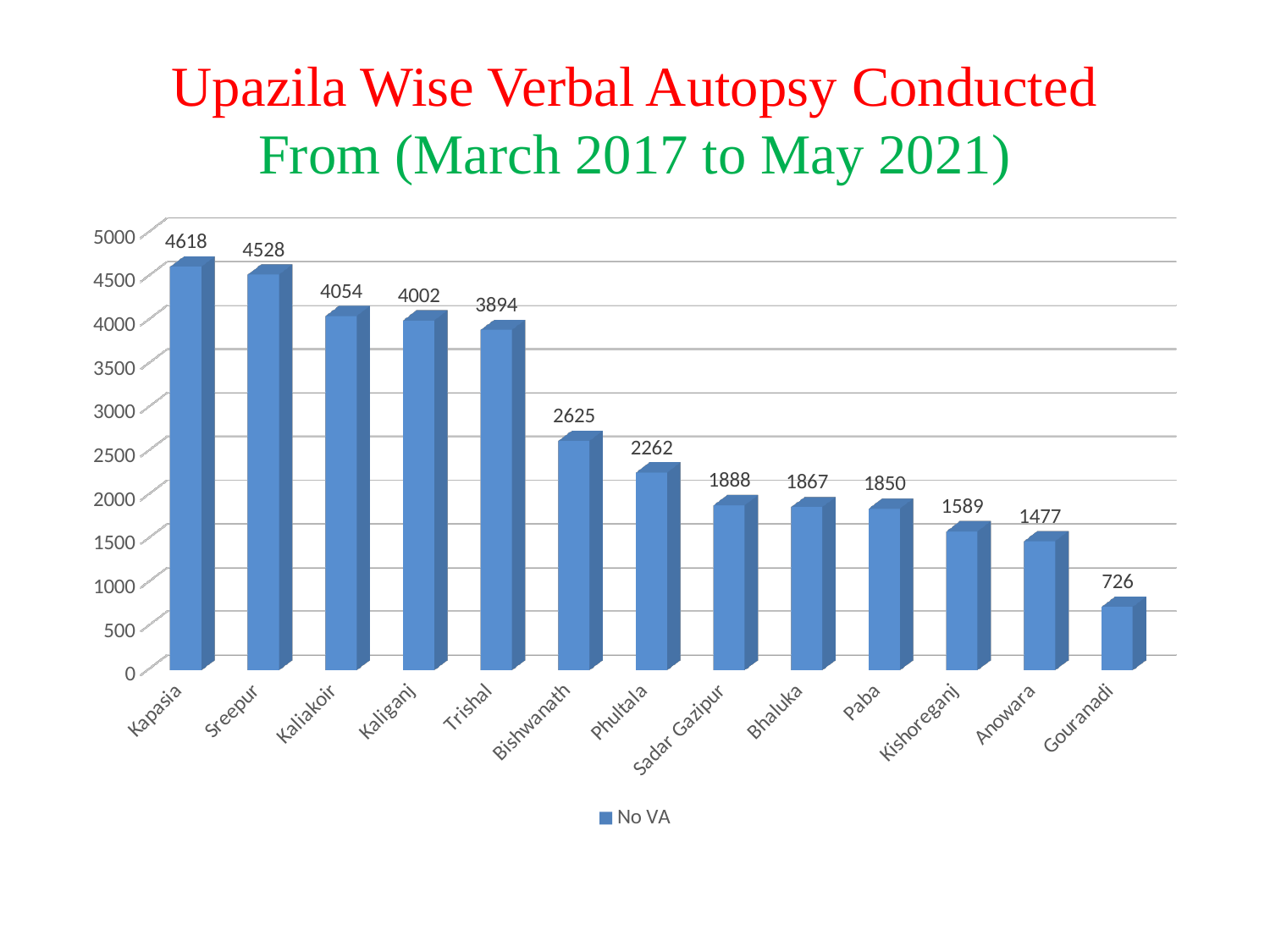
What is the value for Bishwanath? 2625 How many upazilas are shown on the chart? 13 Which upazila has the highest number of verbal autopsies? Kapasia Which is larger, the value for Phultala or the value for Paba? Phultala What kind of chart is shown on the slide? bar chart What is the value for Kapasia? 4618 What is the legend entry for the series shown? No VA What is the difference between the values for Trishal and Bishwanath? 1269 Is the value for Kishoreganj greater or less than 2000? less Which upazila has the lowest number of verbal autopsies? Gouranadi What is the difference between the values for Kapasia and Sreepur? 90 What is the value for Gouranadi? 726